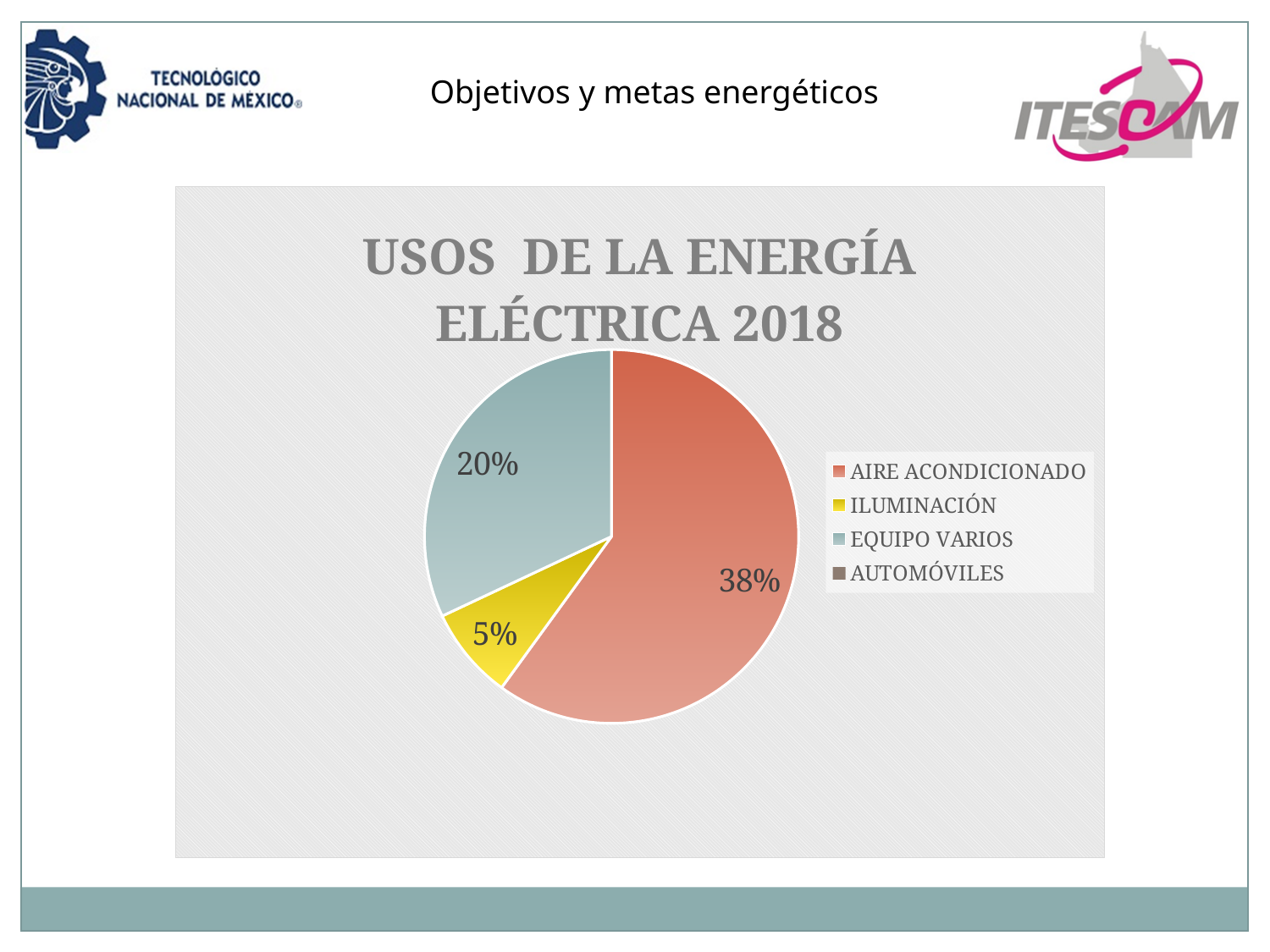
Which category has the largest slice of the pie? AIRE ACONDICIONADO Which is larger, the share for EQUIPO VARIOS or the share for ILUMINACIÓN? EQUIPO VARIOS What type of chart is shown on the slide? Pie chart How many categories does the legend list? 4 What is the title of the chart? USOS DE LA ENERGÍA ELÉCTRICA 2018 What colour represents ILUMINACIÓN in the pie chart? Yellow What percentage is shown for the ILUMINACIÓN slice? 5% By how many percentage points does the EQUIPO VARIOS label exceed the ILUMINACIÓN label? 15 percentage points What percentage of electrical energy use is labelled for AIRE ACONDICIONADO? 38% Which is larger, the share for AIRE ACONDICIONADO or the share for EQUIPO VARIOS? AIRE ACONDICIONADO What percentage is shown for EQUIPO VARIOS? 20% By how many percentage points does the AIRE ACONDICIONADO label exceed the ILUMINACIÓN label? 33 percentage points